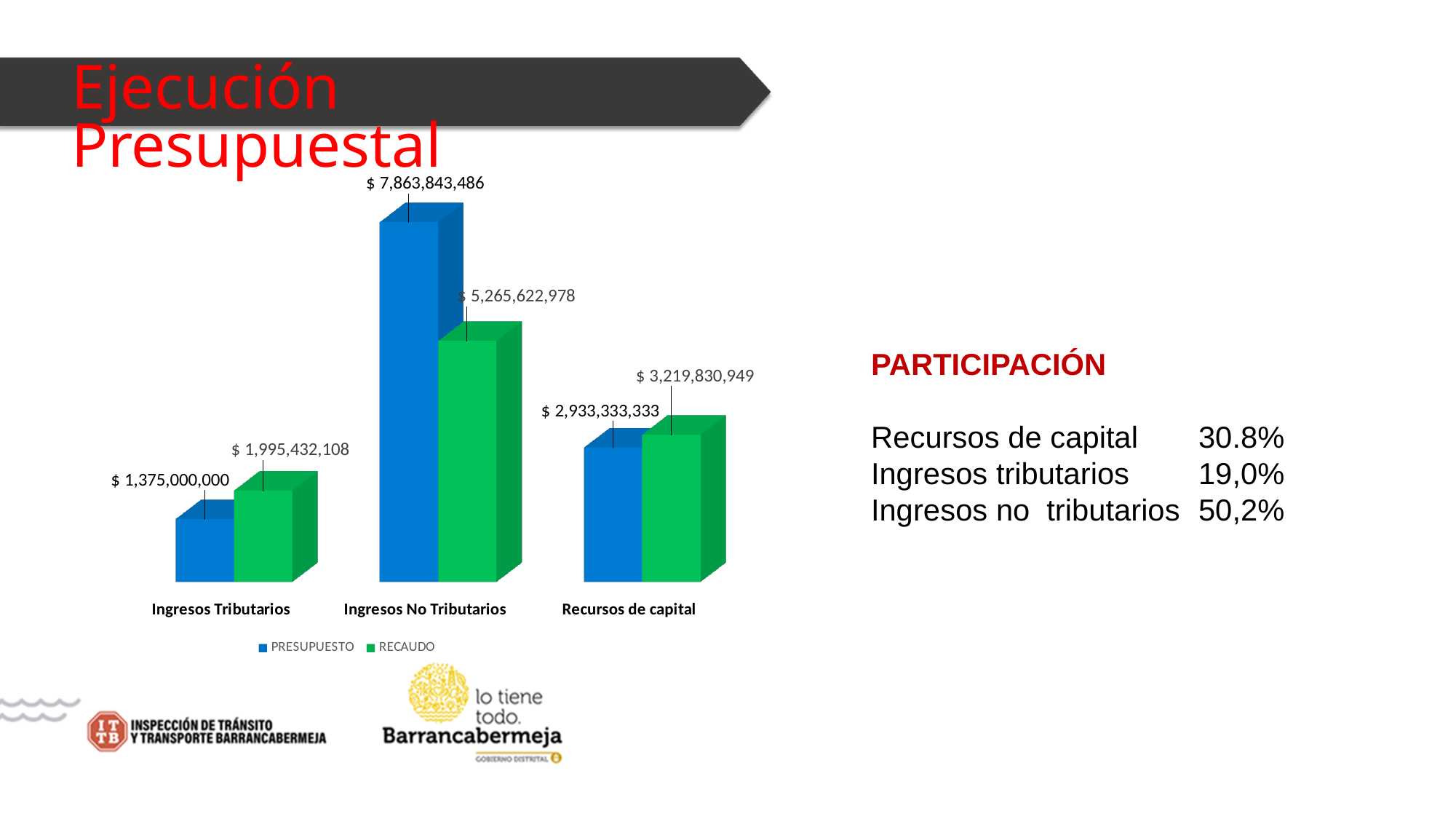
What is the RECAUDO value for Ingresos No Tributarios? $ 5,265,622,978 What kind of chart is shown on the slide? Bar chart How many categories are shown on the x axis of the chart? 3 Which category has the highest PRESUPUESTO value? Ingresos No Tributarios For Recursos de capital, which is larger: PRESUPUESTO or RECAUDO? RECAUDO What is the difference between RECAUDO and PRESUPUESTO for Ingresos Tributarios? $ 620,432,108 What is the RECAUDO value for Ingresos Tributarios? $ 1,995,432,108 How many series does the chart legend list? 2 What is the PRESUPUESTO value for Ingresos No Tributarios? $ 7,863,843,486 Which category has the lowest RECAUDO value? Ingresos Tributarios What is the difference between PRESUPUESTO and RECAUDO for Ingresos No Tributarios? $ 2,598,220,508 What is the PRESUPUESTO value for Recursos de capital? $ 2,933,333,333